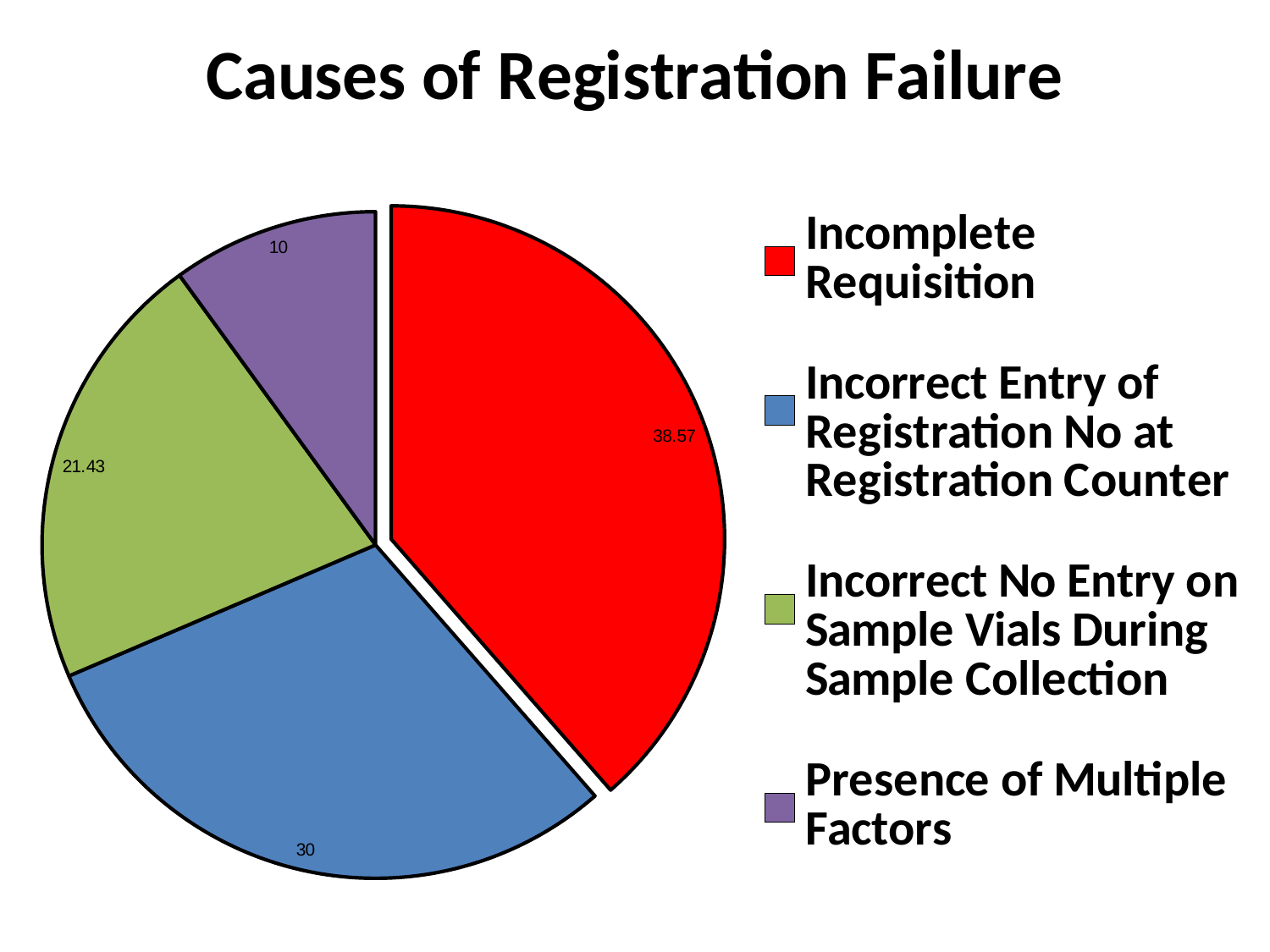
What is the value shown for Incorrect Entry of Registration No at Registration Counter? 30 Which cause has the largest slice of the pie? Incomplete Requisition What type of chart is shown on the slide? Pie chart What is the difference between the values for Incorrect Entry of Registration No at Registration Counter and Incorrect No Entry on Sample Vials During Sample Collection? 8.57 What is the value shown for Presence of Multiple Factors? 10 What is the value shown for Incorrect No Entry on Sample Vials During Sample Collection? 21.43 Which is larger: the slice for Incorrect Entry of Registration No at Registration Counter or the slice for Incorrect No Entry on Sample Vials During Sample Collection? Incorrect Entry of Registration No at Registration Counter How many categories does the pie chart show? 4 What is the difference between the values for Incomplete Requisition and Presence of Multiple Factors? 28.57 Which cause has the smallest slice of the pie? Presence of Multiple Factors What is the value shown for Incomplete Requisition? 38.57 What is the title of the chart? Causes of Registration Failure